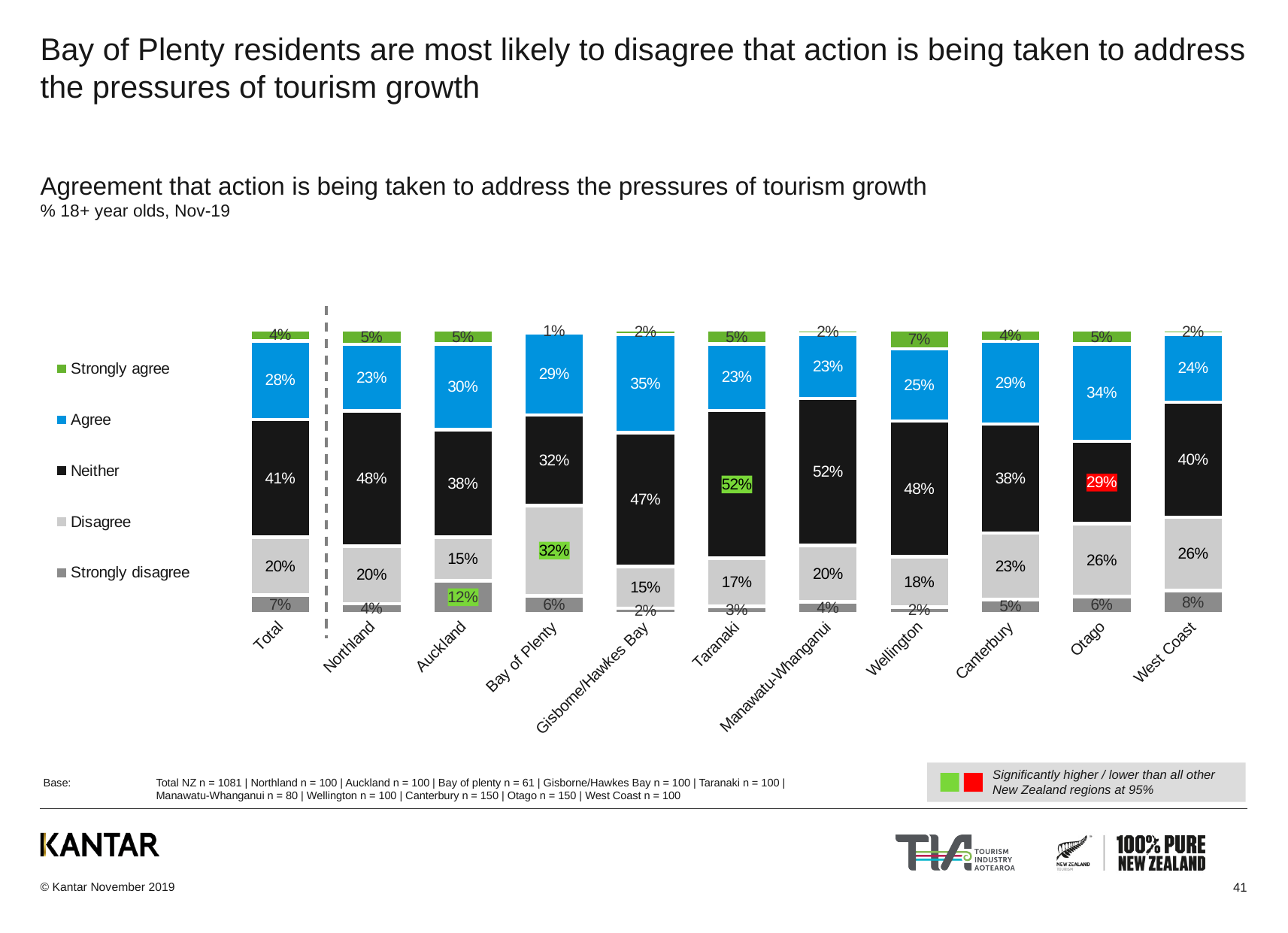
Which region has the lowest 'Neither' percentage? Otago What kind of chart is shown on the slide? Stacked bar chart What is the 'Agree' value for Gisborne/Hawkes Bay? 35% What is the 'Neither' value for Otago? 29% How many series does the legend list? 5 Which has a higher 'Agree' value, Otago or Northland? Otago What is the 'Strongly disagree' value for Auckland? 12% What percentage of Bay of Plenty residents disagree that action is being taken to address the pressures of tourism growth? 32% What is the total of the stacked bar for Total? 100% How many regions (including Total) are shown on the x axis? 11 What is the difference between the 'Neither' values for Taranaki and Total? 11% Which region has the highest 'Disagree' percentage? Bay of Plenty